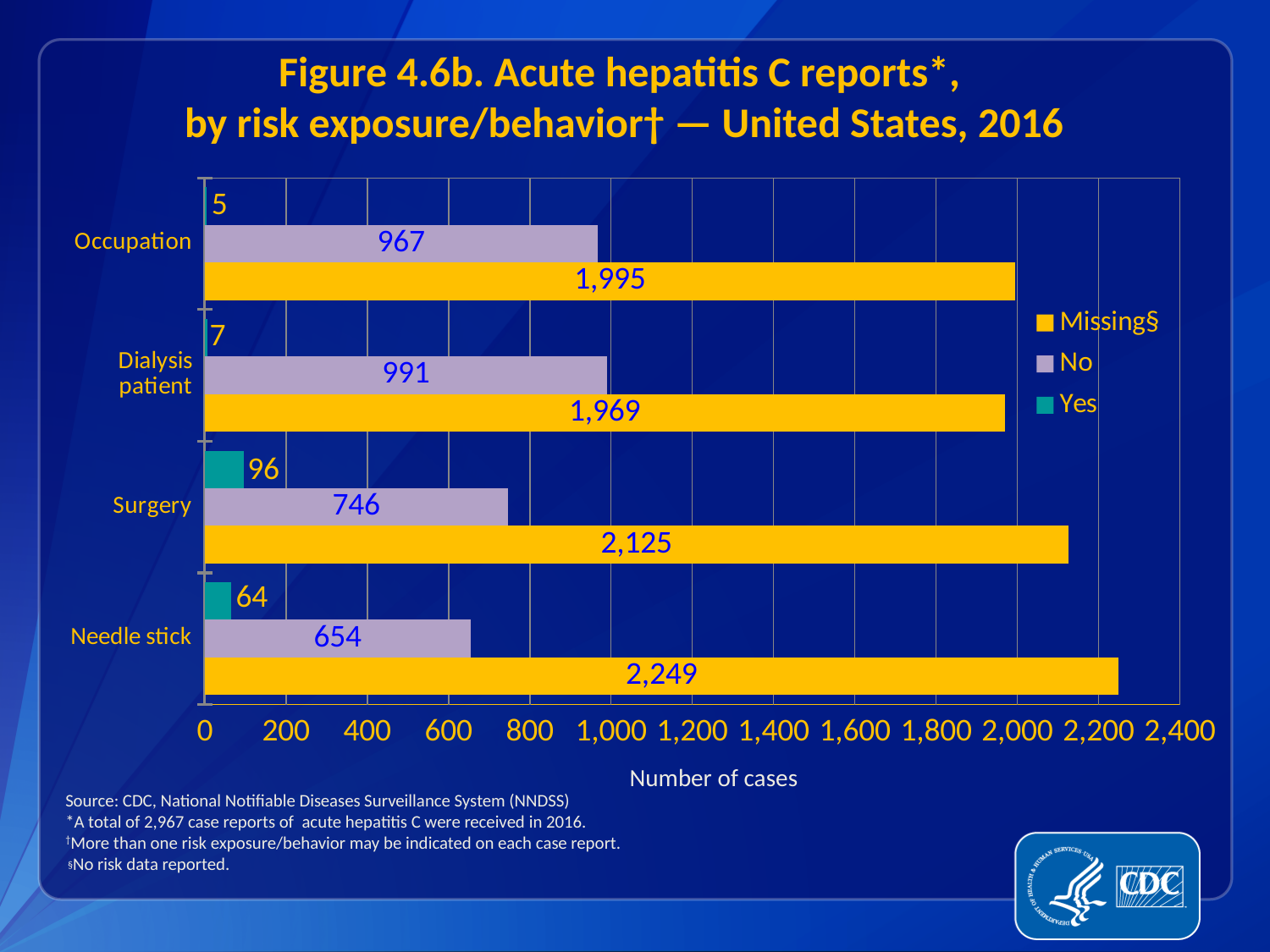
How many series does the legend list? 3 What is the number of cases for Surgery in the Yes series? 96 How many risk exposure/behavior categories are shown on the chart? 4 Which risk exposure/behavior has the lowest value in the Yes series? Occupation What is the number of cases for Needle stick in the No series? 654 Which is larger: the Missing§ value for Surgery or the Missing§ value for Dialysis patient? Surgery What is the number of cases for Dialysis patient in the Yes series? 7 Which risk exposure/behavior has the highest value in the Missing§ series? Needle stick What kind of chart is shown on the slide? Bar chart What is the difference between the No values for Dialysis patient and Surgery? 245 What is the label of the x axis? Number of cases What is the number of cases for Occupation in the Missing§ series? 1,995